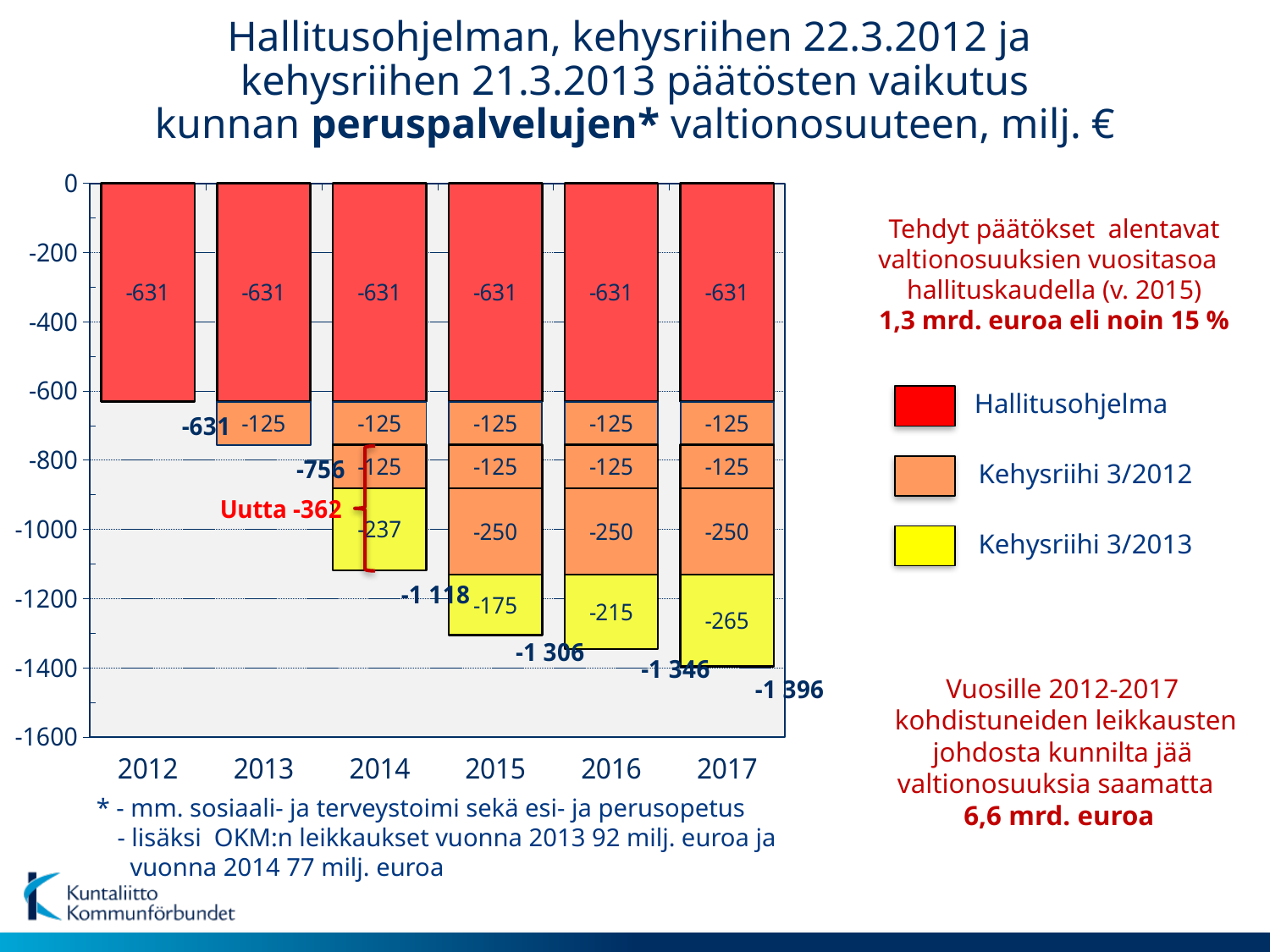
Which year has the larger Kehysriihi 3/2013 cut, 2015 or 2016? 2016 What kind of chart is shown on the slide? bar chart What is the Kehysriihi 3/2013 value for 2017? -265 Which year has the largest total cut in the chart? 2017 By how much does the Kehysriihi 3/2013 cut for 2017 exceed that for 2016? 50 How many years are shown on the x axis of the chart? 6 How many series does the chart's legend list? 3 What colour represents Kehysriihi 3/2013 in the legend? yellow What is the total value of the stacked bar for 2017? -1 396 What is the Kehysriihi 3/2013 value for 2014? -237 What is the Hallitusohjelma value for 2015? -631 What is the total value of the stacked bar for 2015? -1 306